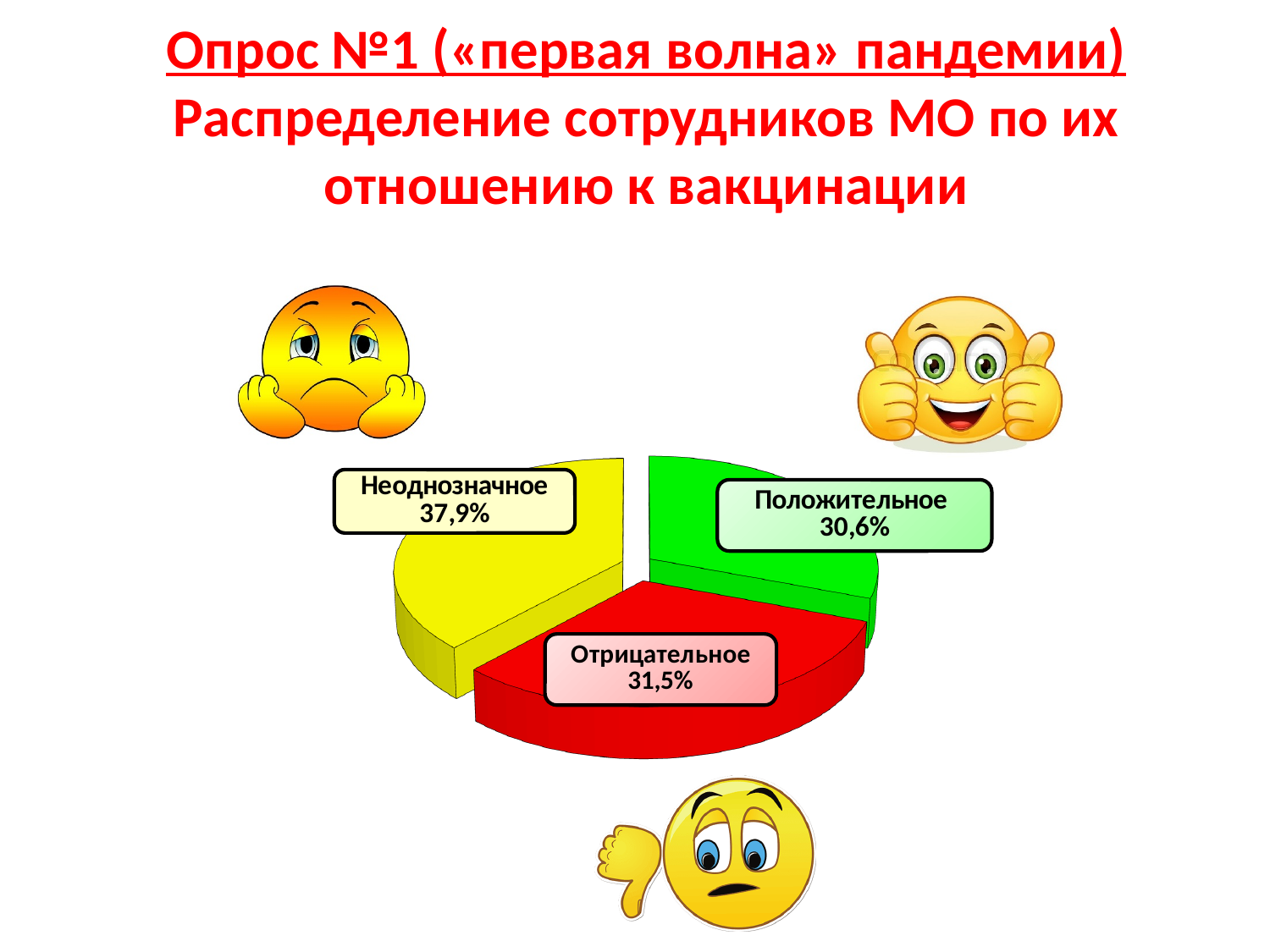
Which is larger, the Отрицательное slice or the Положительное slice? Отрицательное What percentage of employees had an ambiguous (Неоднозначное) attitude toward vaccination? 37,9% What colour is the Отрицательное slice of the pie chart? Red What share of the pie does the Отрицательное slice represent? 31,5% What kind of chart is shown on the slide? Pie chart How many categories does the pie chart show? 3 What is the difference in percentage points between the Отрицательное and Положительное slices? 0,9 Which attitude category has the smallest share of the pie? Положительное What percentage of employees had a negative (Отрицательное) attitude toward vaccination? 31,5% What percentage of employees had a positive (Положительное) attitude toward vaccination? 30,6% What is the difference in percentage points between the Неоднозначное and Положительное slices? 7,3 Which attitude category has the largest share of the pie? Неоднозначное